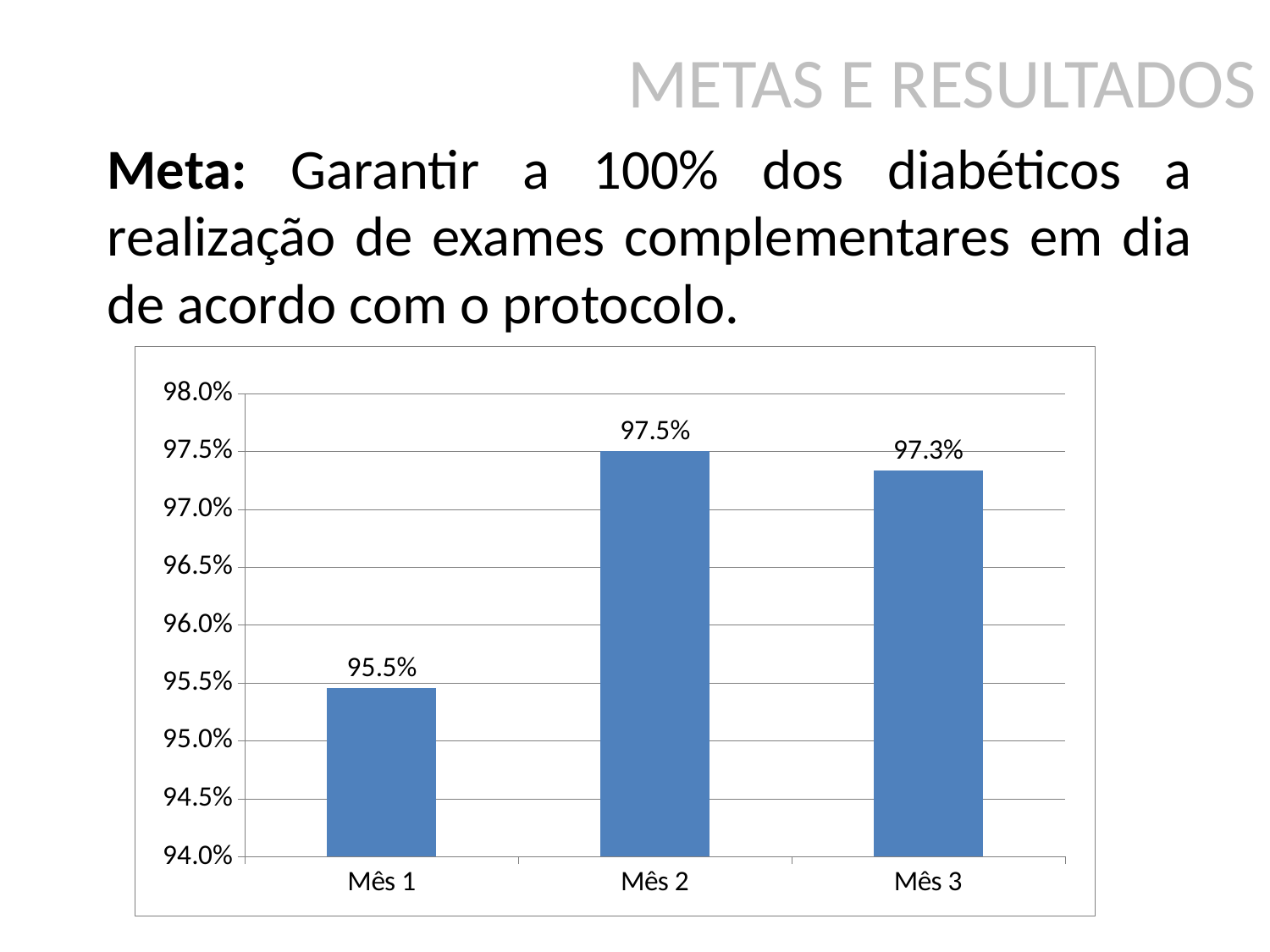
What is the value for Mês 3? 97.3% Which month has the lowest value? Mês 1 What is the value for Mês 2? 97.5% How many categories are shown on the x axis? 3 What is the highest value shown on the y axis? 98.0% What kind of chart is shown on the slide? bar chart What is the value for Mês 1? 95.5% What is the difference between the values for Mês 2 and Mês 1? 2.0% Is the value for Mês 3 greater or less than 97.0%? greater Is the value for Mês 1 greater or less than 96.0%? less Which month has the highest value? Mês 2 Which is larger, the value for Mês 1 or the value for Mês 3? Mês 3